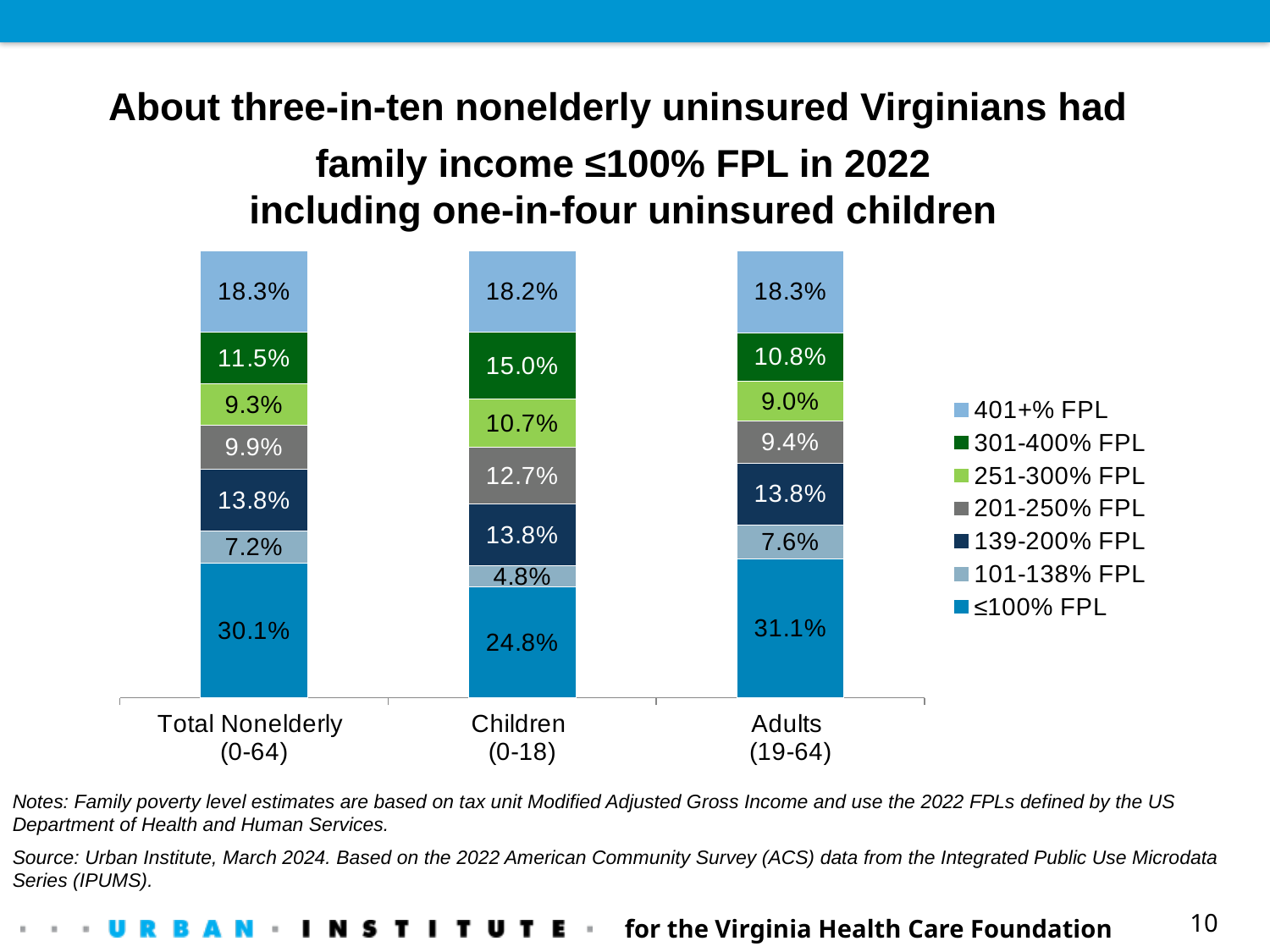
What is the difference between the ≤100% FPL share for Adults (19-64) and for Children (0-18)? 6.3 percentage points Which is larger: the 201-250% FPL share for Children (0-18) or for Adults (19-64)? Children (0-18) How many categories (bars) are shown on the x axis? 3 Which category has the highest ≤100% FPL share? Adults (19-64) Which legend entry is shown in the lightest blue colour at the top of each bar? 401+% FPL What kind of chart is shown on the slide? Stacked bar chart What is the ≤100% FPL share for Children (0-18)? 24.8% What is the 301-400% FPL share for Adults (19-64)? 10.8% Which category has the lowest 101-138% FPL share? Children (0-18) What is the 101-138% FPL share for Total Nonelderly (0-64)? 7.2% What is the total of the stacked bar for Adults (19-64)? 100.0% How many series does the legend list? 7